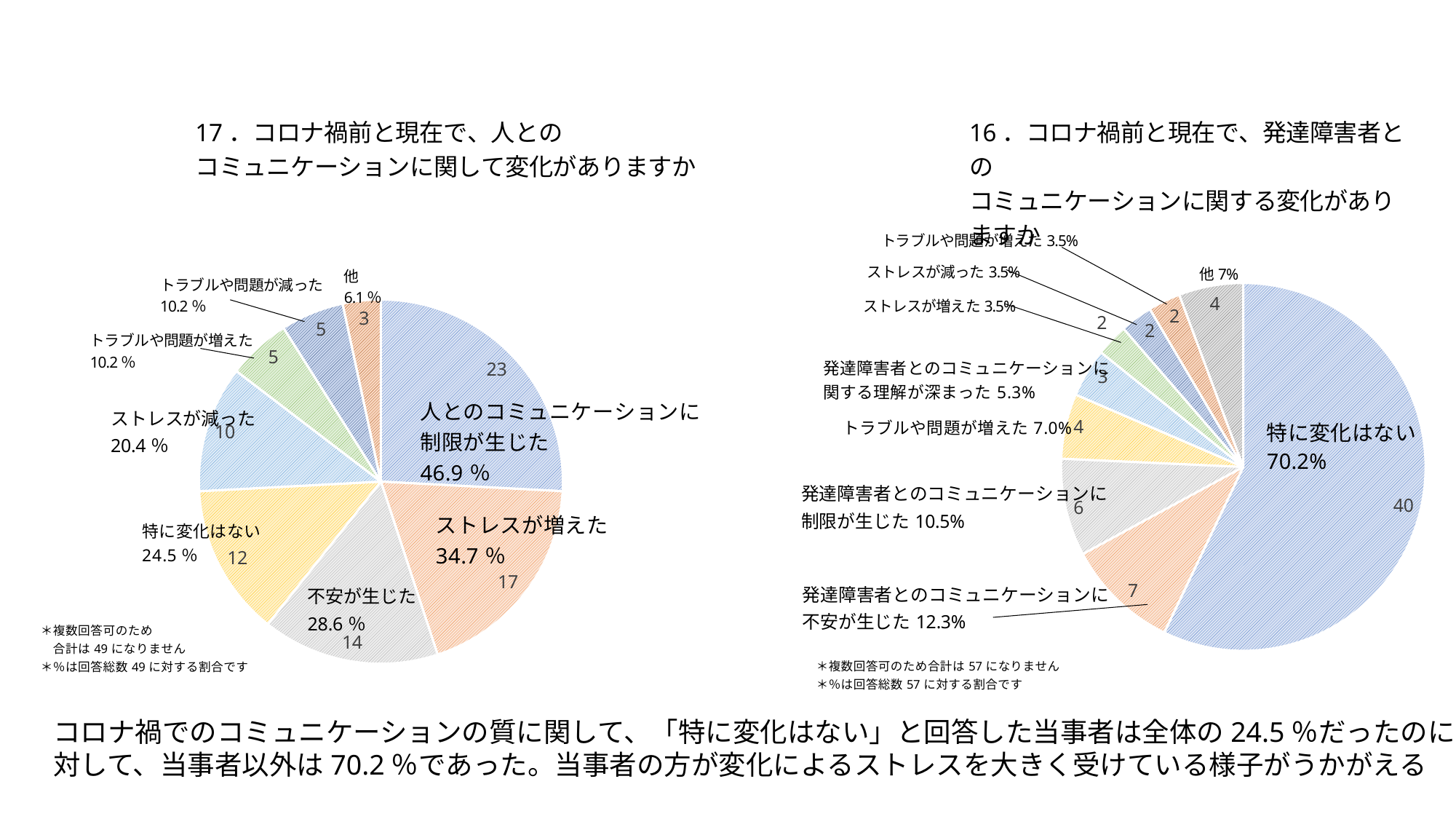
On the right pie chart (question 16), which is larger: 発達障害者とのコミュニケーションに制限が生じた or 発達障害者とのコミュニケーションに不安が生じた? 発達障害者とのコミュニケーションに不安が生じた On the left pie chart (question 17), how many slices does the pie have? 8 On the left pie chart (question 17), which category has the largest slice? 人とのコミュニケーションに制限が生じた On the right pie chart (question 16), what count is shown for 発達障害者とのコミュニケーションに不安が生じた? 7 On the right pie chart (question 16), what percentage is shown for 特に変化はない? 70.2% On the left pie chart (question 17), which category has the smallest slice? 他 On the right pie chart (question 16), what percentage is shown for 他? 7% On the left pie chart (question 17), what is the difference in counts between 不安が生じた and 特に変化はない? 2 What type of chart is used on the left side of the slide (question 17)? pie chart On the left pie chart (question 17), what count is shown for ストレスが増えた? 17 On the right pie chart (question 16), which category has the largest slice? 特に変化はない On the left pie chart (question 17), what percentage is shown for 人とのコミュニケーションに制限が生じた? 46.9 %